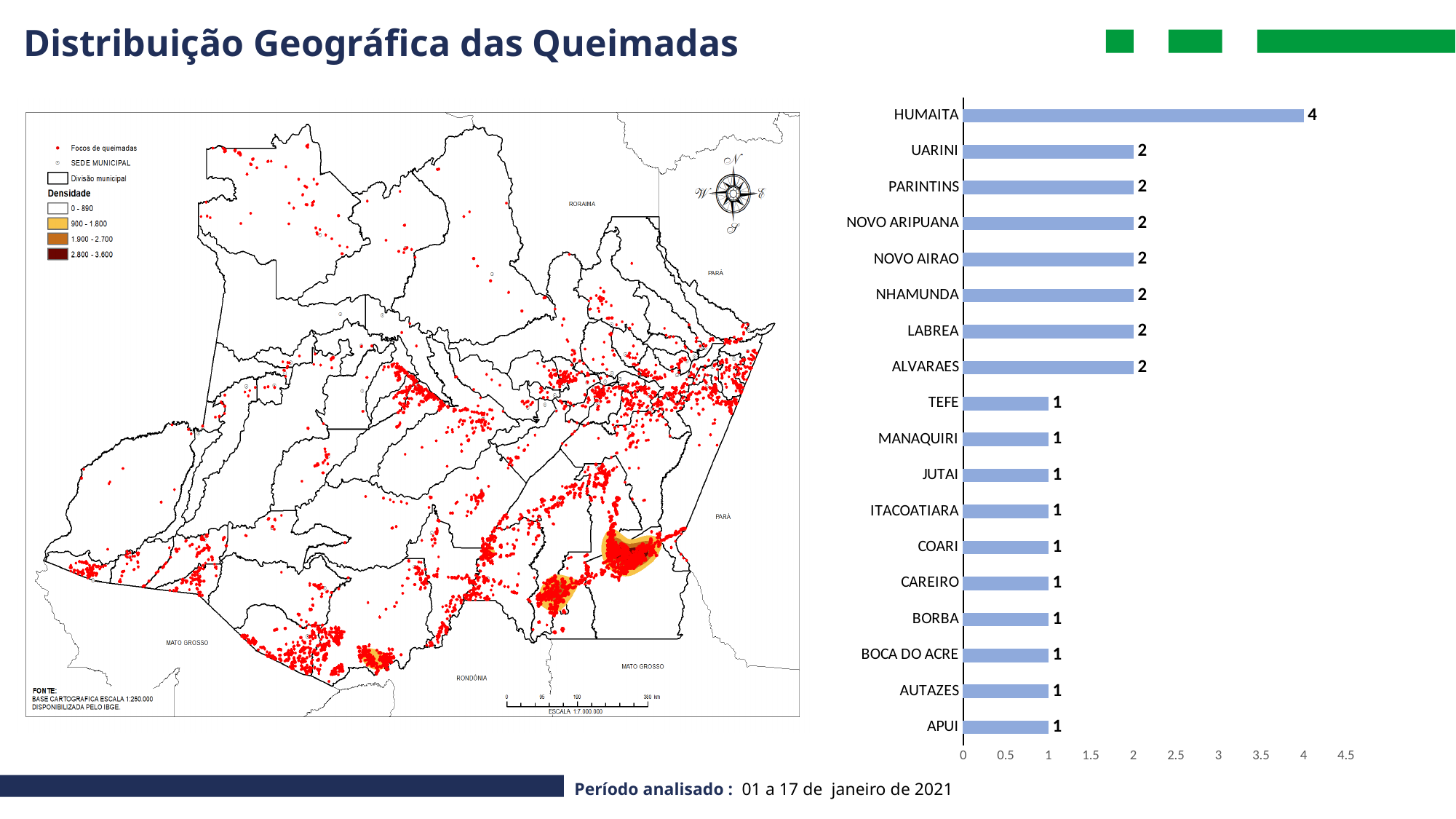
On the bar chart, is the value for HUMAITA greater or less than 3? greater On the bar chart, which has a larger value, NHAMUNDA or COARI? NHAMUNDA On the bar chart, which municipality has the highest value? HUMAITA On the bar chart, which has a larger value, APUI or HUMAITA? HUMAITA On the bar chart, what is the value for NOVO ARIPUANA? 2 How many municipalities are shown on the bar chart? 18 What kind of chart is shown on the right side of the slide? bar chart On the bar chart, what is the difference between the values for HUMAITA and UARINI? 2 On the bar chart, what is the value for BOCA DO ACRE? 1 On the bar chart, what is the value for HUMAITA? 4 On the bar chart, what is the value for LABREA? 2 On the bar chart, what is the difference between the values for PARINTINS and TEFE? 1